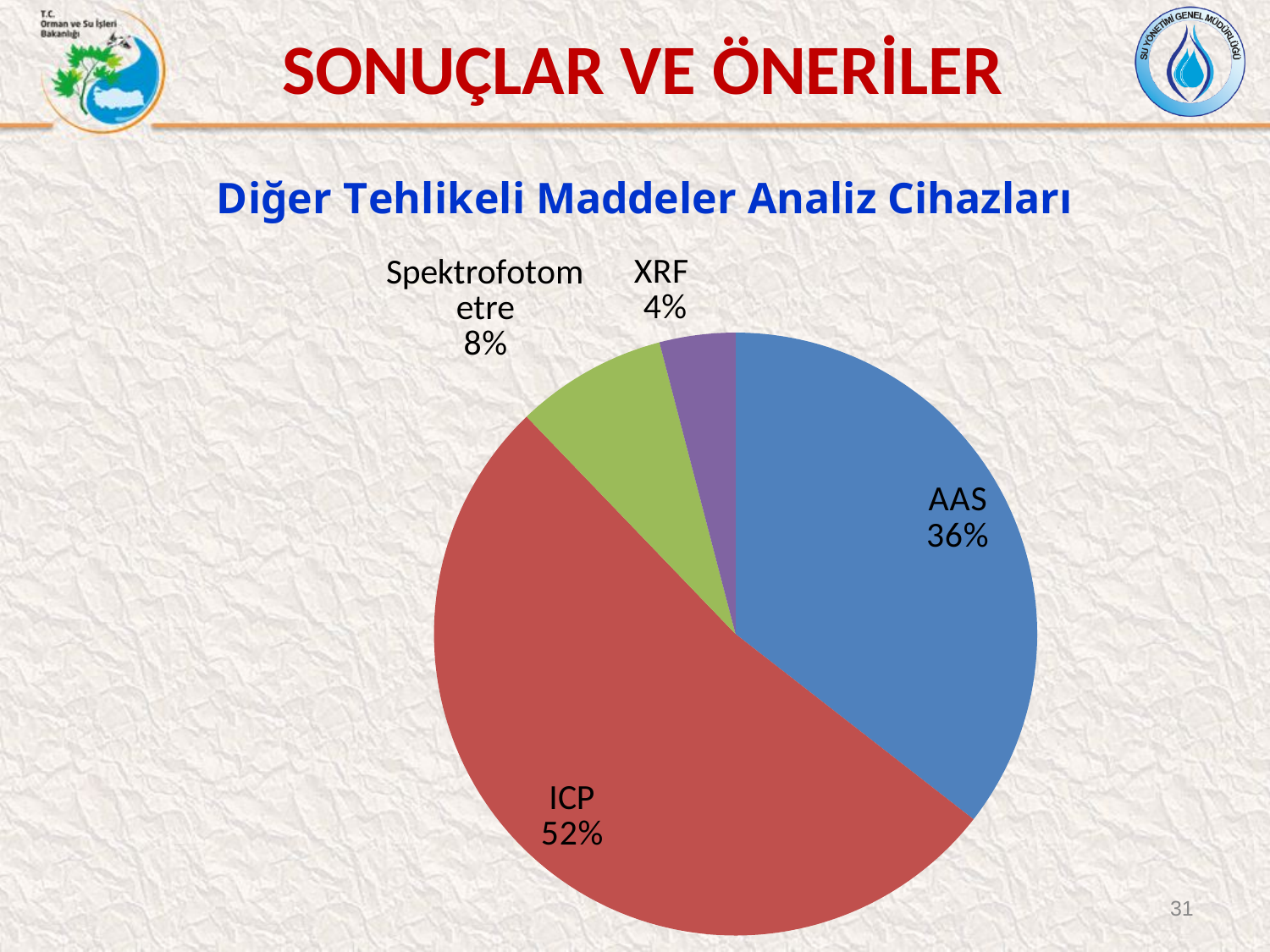
What share of the pie does AAS have? 36% How many categories are shown in the pie chart? 4 What is the title of the chart? Diğer Tehlikeli Maddeler Analiz Cihazları What share of the pie does XRF have? 4% Which category has the smallest slice of the pie? XRF Which category has the largest slice of the pie? ICP What share of the pie does ICP have? 52% What is the difference in percentage points between ICP and AAS? 16 Which is larger, the share for AAS or the share for Spektrofotometre? AAS What kind of chart is shown on the slide? Pie chart What is the difference in percentage points between Spektrofotometre and XRF? 4